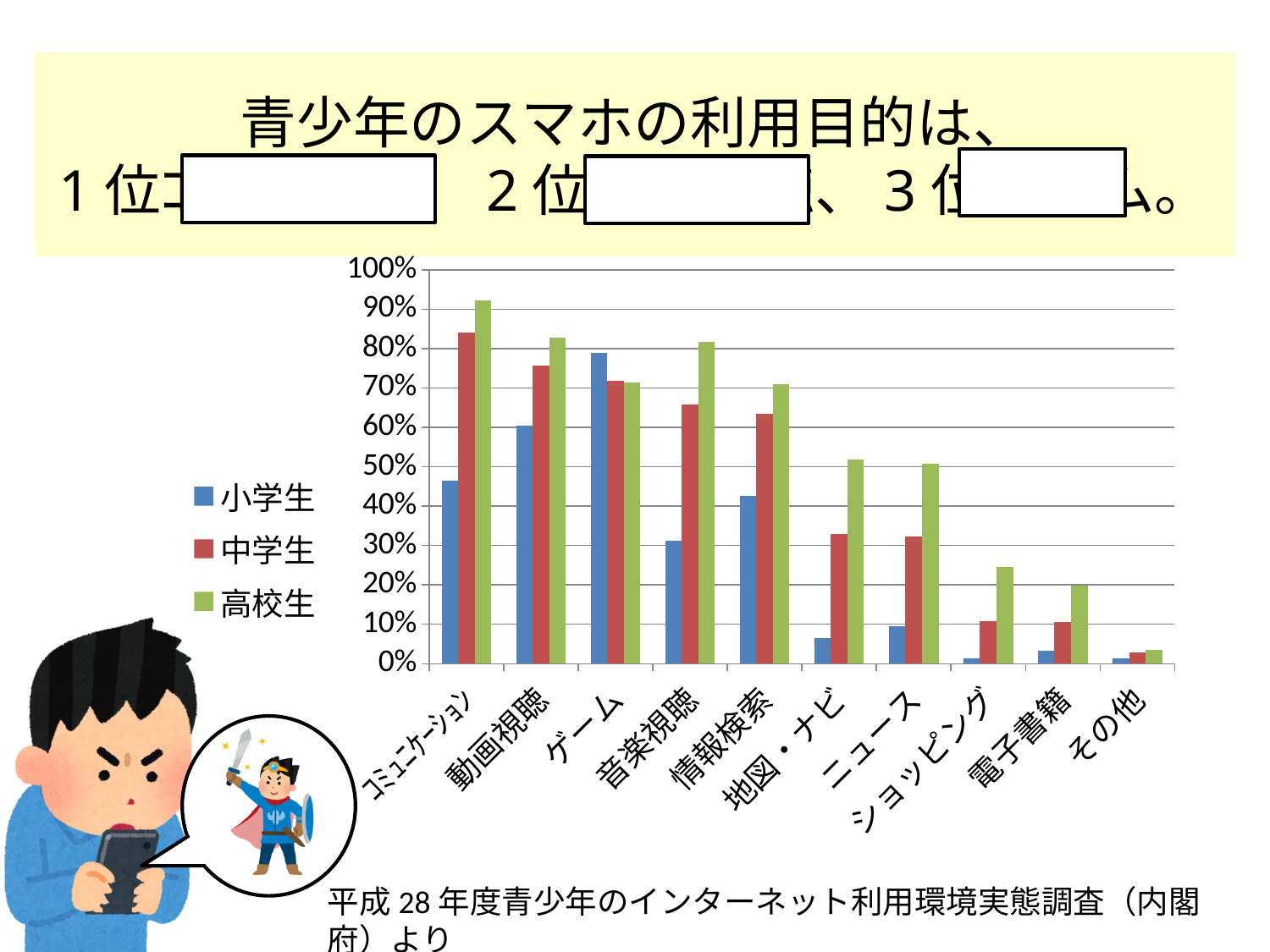
Which category has the highest value for 高校生? コミュニケーション For 音楽視聴, which is larger: the value for 中学生 or the value for 高校生? 高校生 Is the value for 高校生 in コミュニケーション greater or less than 80%? greater For ゲーム, which is larger: the value for 小学生 or the value for 高校生? 小学生 Is the value for 小学生 in 音楽視聴 greater or less than 40%? less How many series does the legend list? 3 How many categories are shown on the x axis of the chart? 10 Which category has the lowest value for 高校生? その他 Is the value for 中学生 in 地図・ナビ greater or less than 40%? less What kind of chart is shown on the slide? bar chart Which category has the highest value for 小学生? ゲーム What colour represents 高校生 in the chart? green